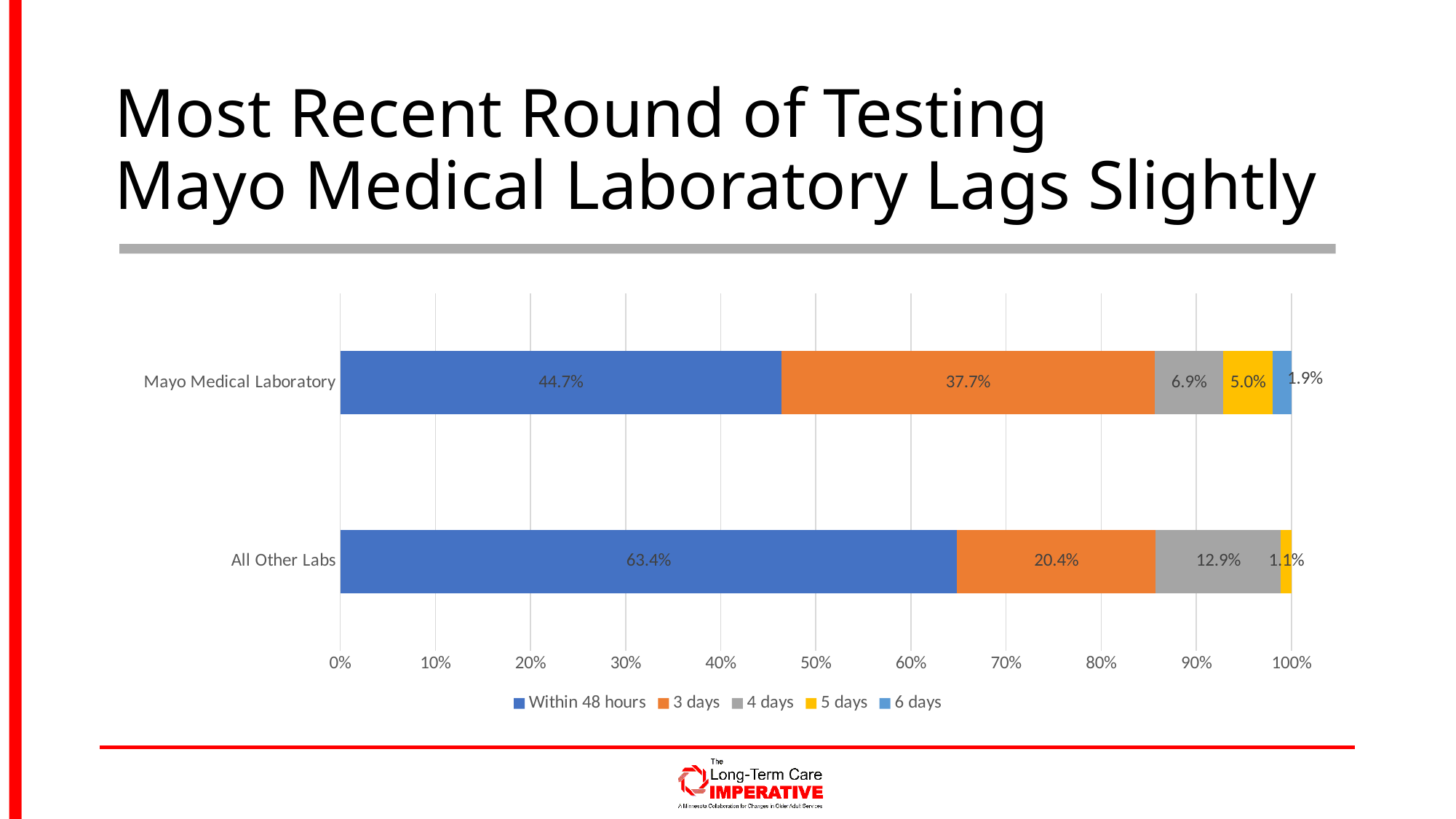
Which lab has the larger Within 48 hours share, Mayo Medical Laboratory or All Other Labs? All Other Labs What percentage of Mayo Medical Laboratory tests were returned within 48 hours? 44.7% What is the 3 days value for Mayo Medical Laboratory? 37.7% What is the difference between the Within 48 hours values for All Other Labs and Mayo Medical Laboratory? 18.7% How many series does the legend list? 5 Which series is shown in orange in the legend? 3 days What kind of chart is shown on the slide? Stacked bar chart What is the 4 days value for All Other Labs? 12.9% What is the 6 days value for Mayo Medical Laboratory? 1.9% What is the difference between the 3 days values for Mayo Medical Laboratory and All Other Labs? 17.3% How many categories (labs) are plotted on the chart? 2 What percentage of All Other Labs tests were returned within 48 hours? 63.4%